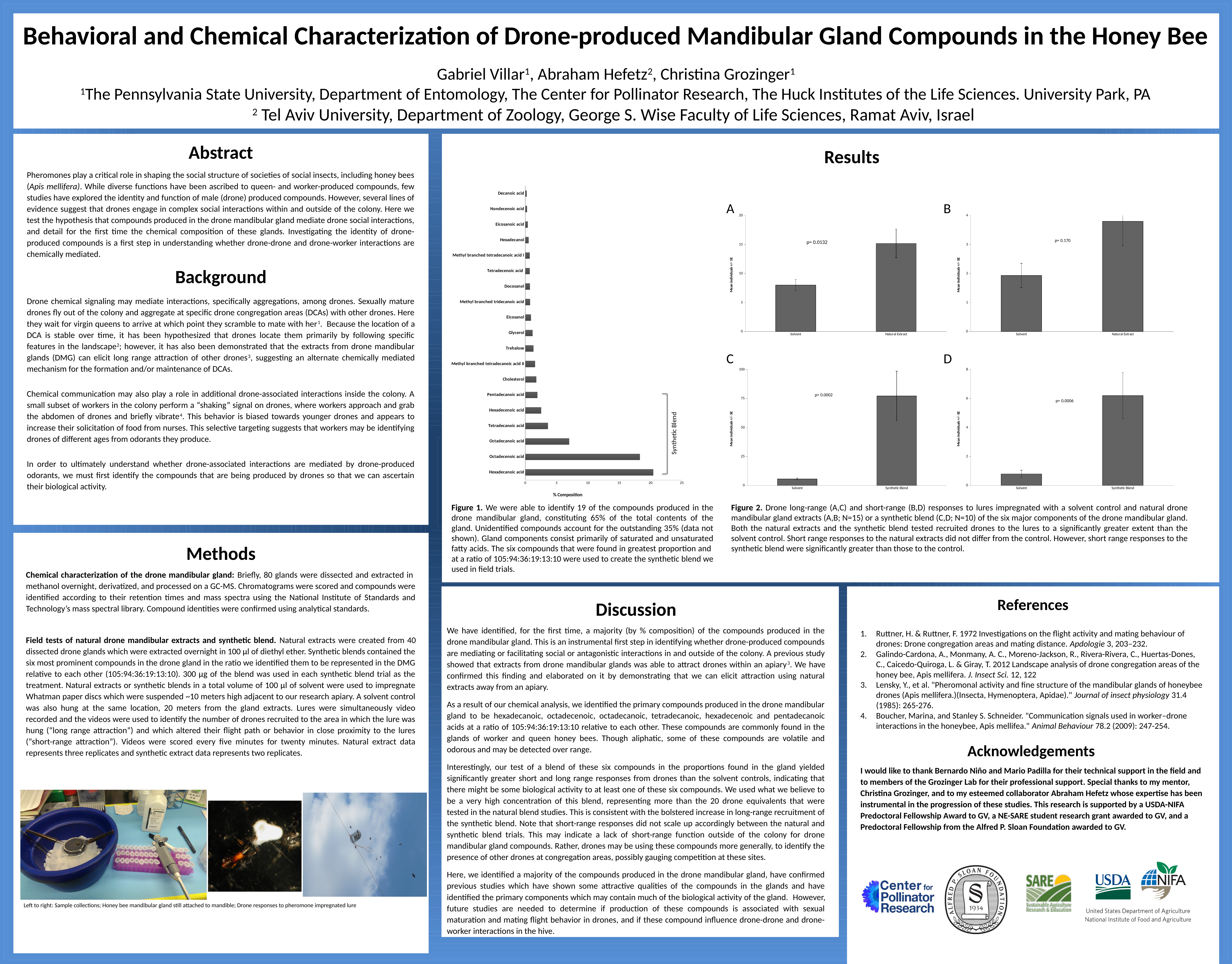
In Figure 1, is the value for Octadecenoic acid greater or less than 15? greater In Figure 2 panel C, is the value for Synthetic Blend greater or less than 50? greater In Figure 1, is the value for Octadecanoic acid greater or less than 10? less In Figure 1, which compound has the highest % Composition? Hexadecanoic acid In Figure 1, which has a larger % Composition, Octadecenoic acid or Tetradecanoic acid? Octadecenoic acid In Figure 2 panel A, which bar is taller, Solvent or Natural Extract? Natural Extract In Figure 1, how many compounds are listed on the vertical axis? 19 In Figure 2 panel A, what p-value is printed on the chart? p= 0.0132 In Figure 1, what is the label on the horizontal axis? % Composition What kind of chart is Figure 1 (the % Composition chart)? bar chart